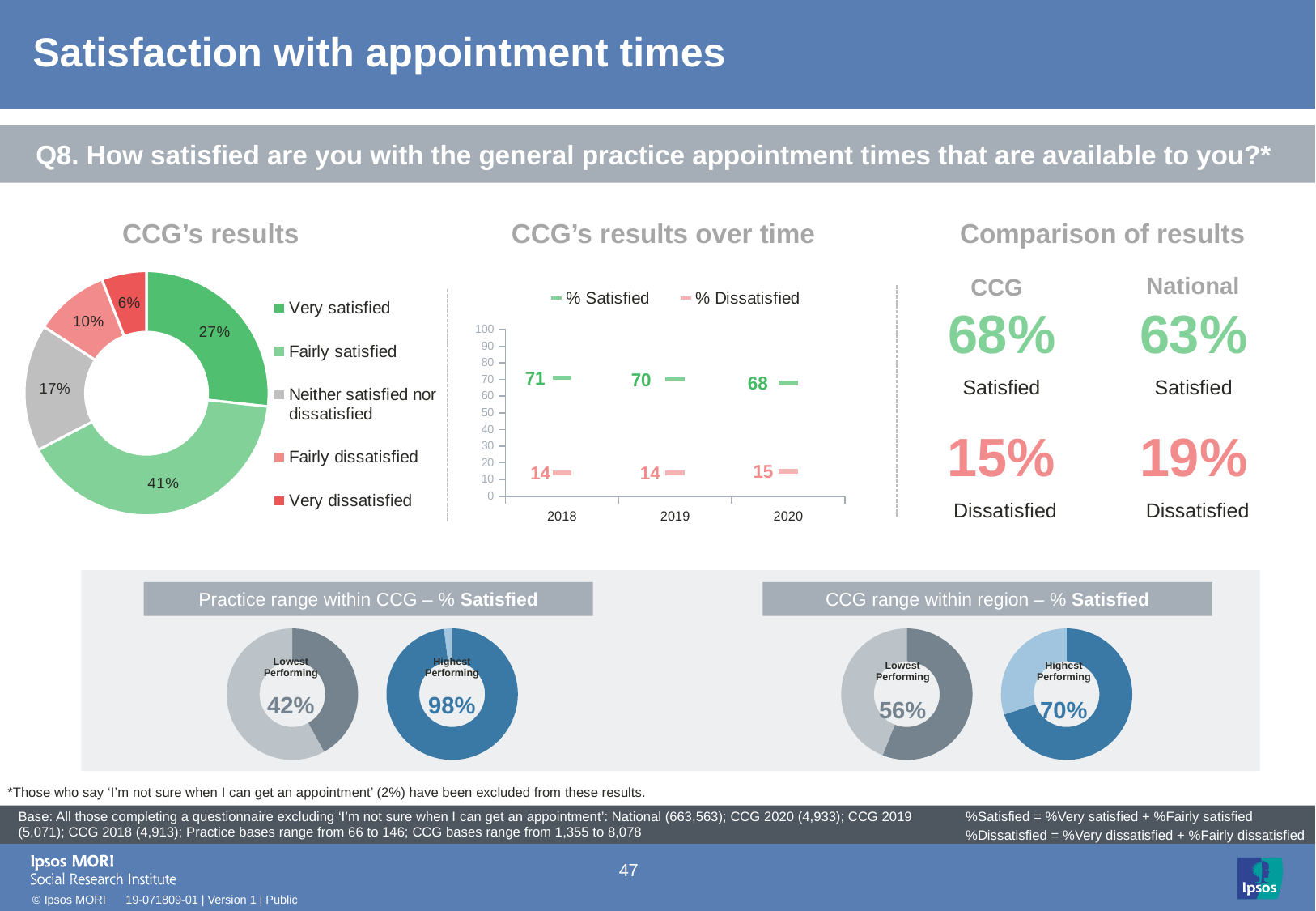
In the 'CCG's results' donut chart, what percentage is shown for 'Very dissatisfied'? 6% In the 'CCG's results over time' chart, how many series does the legend list? 2 In the 'CCG's results' donut chart, how many categories does the legend list? 5 In the 'CCG's results' donut chart, what is the difference between the 'Very satisfied' and 'Neither satisfied nor dissatisfied' shares? 10% In the 'CCG's results' donut chart, which category has the largest share? Fairly satisfied In the 'CCG's results over time' chart, how many years are shown on the x axis? 3 In the 'Practice range within CCG – % Satisfied' section, what is the Highest Performing value? 98% In the 'CCG's results over time' chart, what is the % Satisfied value for 2018? 71 In the 'CCG's results over time' chart, does the % Satisfied series rise or fall from 2018 to 2020? fall In the 'CCG's results' donut chart, which category has the smallest share? Very dissatisfied In the 'CCG's results over time' chart, what is the % Dissatisfied value for 2020? 15 In the 'CCG's results' donut chart, what percentage is shown for 'Fairly satisfied'? 41%